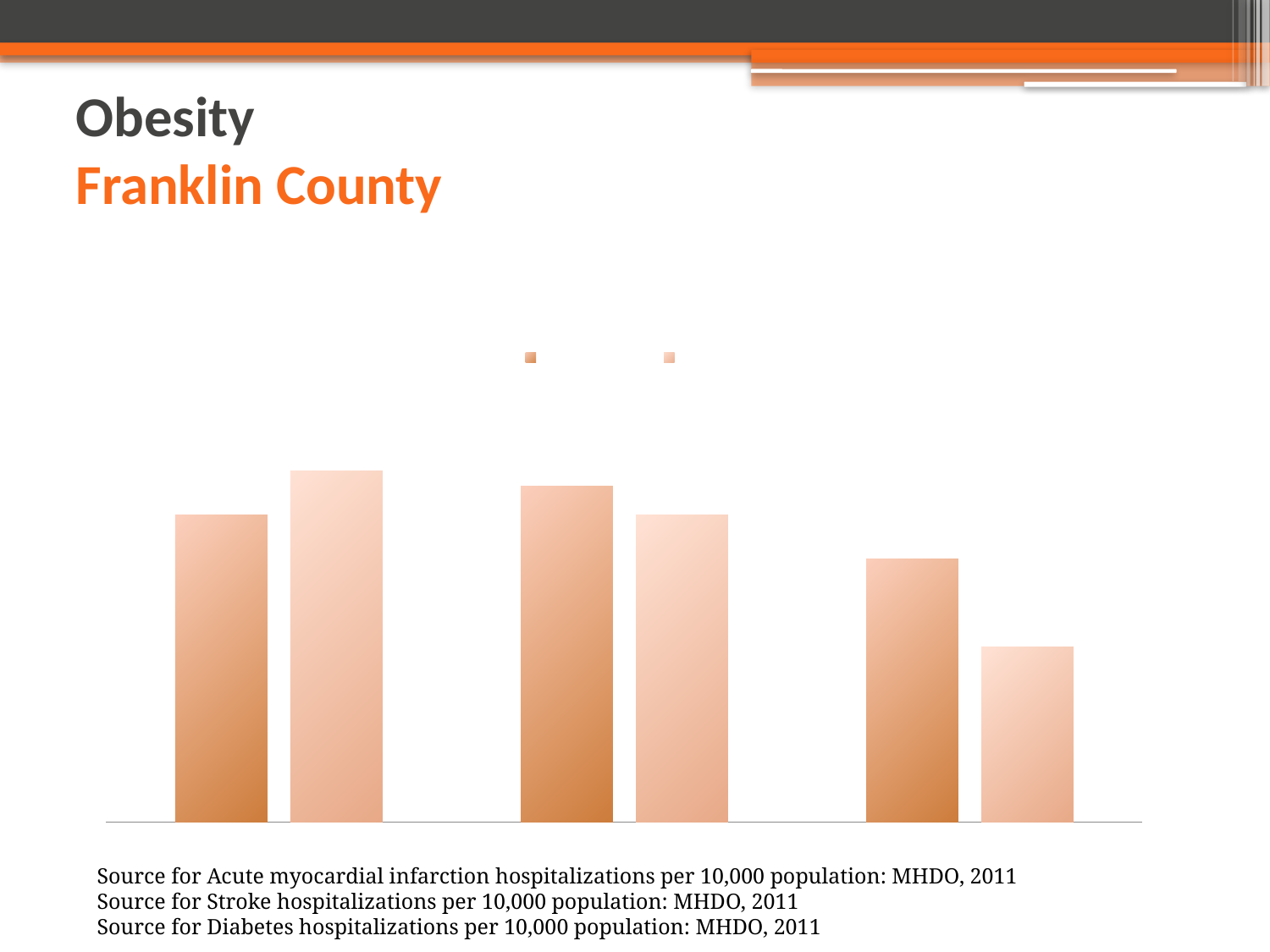
Which bar is the shortest in the chart? the lighter orange bar in the rightmost group In the rightmost group of bars, which bar is taller, the darker orange bar or the lighter orange bar? the darker orange bar Which bar is the tallest in the chart? the lighter orange bar in the leftmost group How many groups of bars does the chart have? 3 In the middle group of bars, which bar is taller, the darker orange bar or the lighter orange bar? the darker orange bar How many bars are plotted in the chart? 6 What kind of chart is shown on the slide? bar chart In the leftmost group of bars, which bar is taller, the darker orange bar or the lighter orange bar? the lighter orange bar Do the darker orange bars rise or fall from left to right across the chart? neither consistently; they rise from the first group to the second, then fall Which county is named in the slide title above the chart? Franklin County Do the lighter orange bars rise or fall from left to right across the chart? fall How many series does the chart's legend list? 2